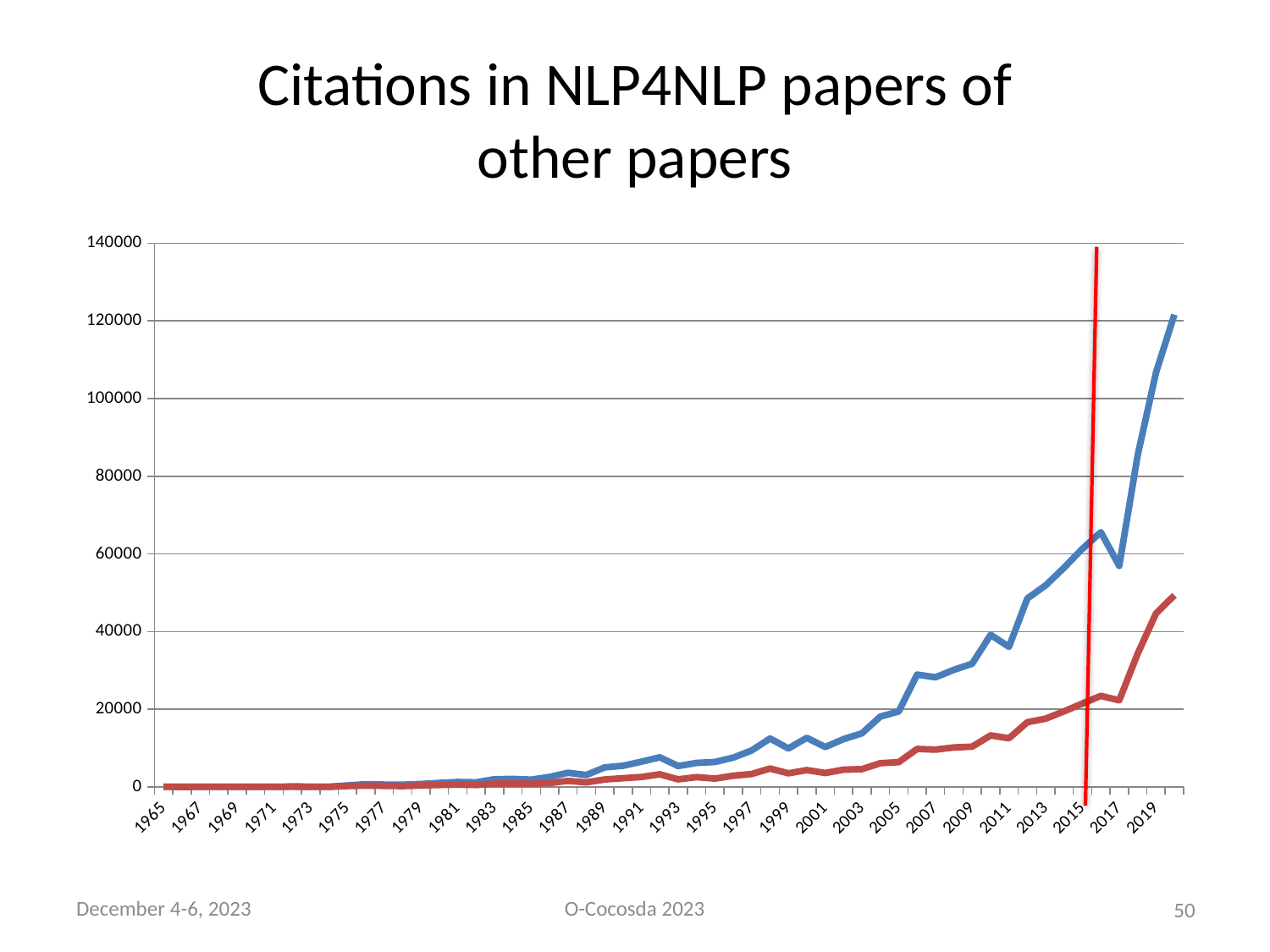
Is the value of the blue line at 2019 greater or less than 100000? greater Is the value of the red line at 2011 greater or less than 20000? less In which year does the blue line reach its highest value? 2020 What is the highest value labelled on the vertical axis? 140000 Is the value of the blue line at 2013 greater or less than 40000? greater How many lines (data series) are plotted on the chart? 2 Overall, do the plotted values rise or fall from 1965 to 2019? rise What kind of chart is shown on the slide? line chart Which line is higher at 2019, the blue line or the red line? the blue line What is the title of the chart? Citations in NLP4NLP papers of other papers